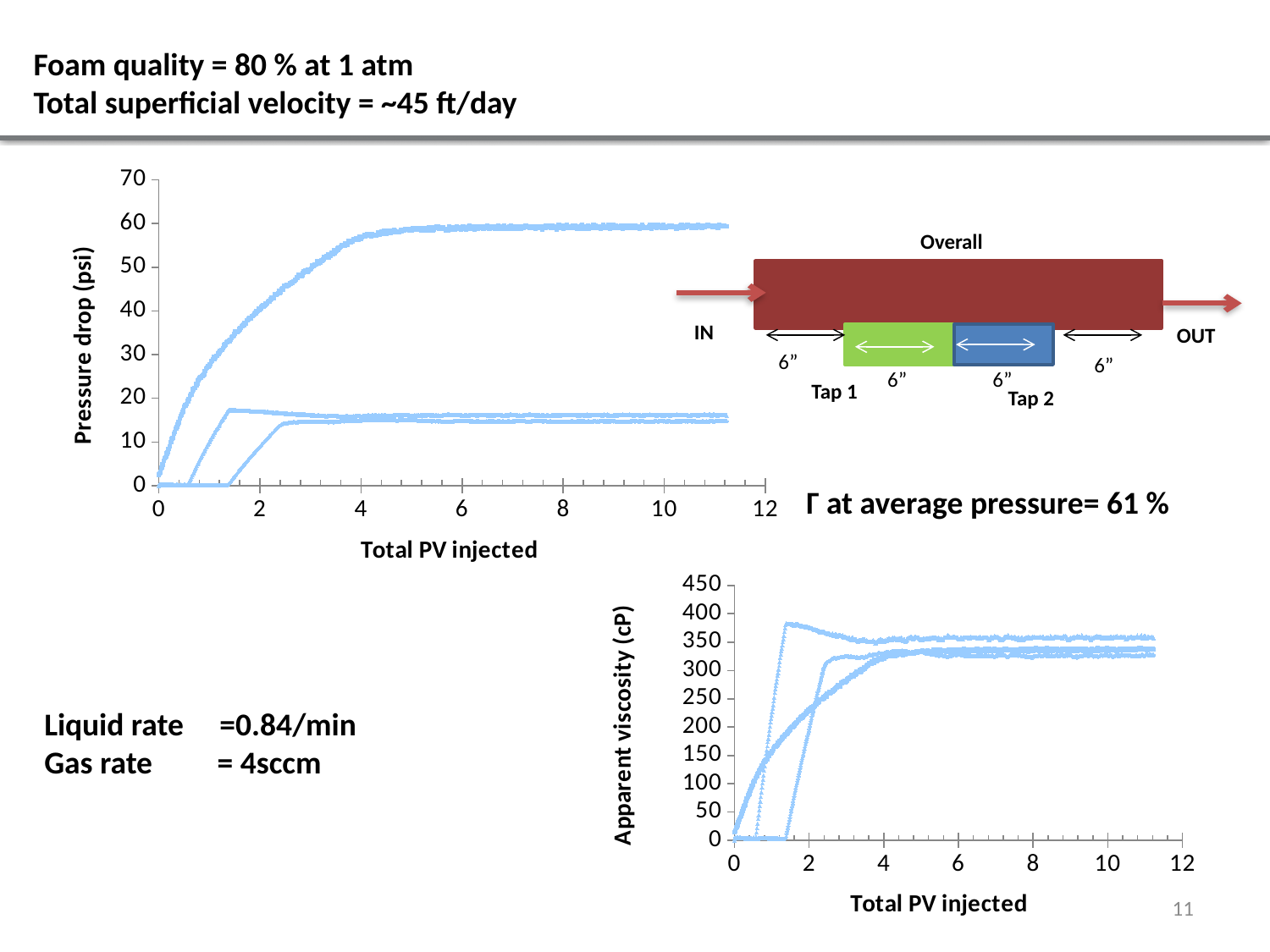
In the bottom-right apparent viscosity chart, is the plateau value of the highest line greater or less than 300? greater What kind of chart is the bottom-right chart with the y axis labelled Apparent viscosity (cP)? line chart In the bottom-right chart, what is the label of the y axis? Apparent viscosity (cP) In the bottom-right apparent viscosity chart, is the peak value of the line that rises most steeply greater or less than 400? less In the top-left pressure drop chart, do the values rise or fall as Total PV injected increases from 0 to 4? rise In the bottom-right apparent viscosity chart, how many lines are plotted? 3 In the top-left pressure drop chart, is the plateau value of the highest line greater or less than 50? greater In the bottom-right apparent viscosity chart, what is the highest value shown on the y axis? 450 What kind of chart is the top-left chart with the y axis labelled Pressure drop (psi)? line chart In the top-left pressure drop chart, how many lines are plotted? 3 In the top-left pressure drop chart, what is the label of the x axis? Total PV injected